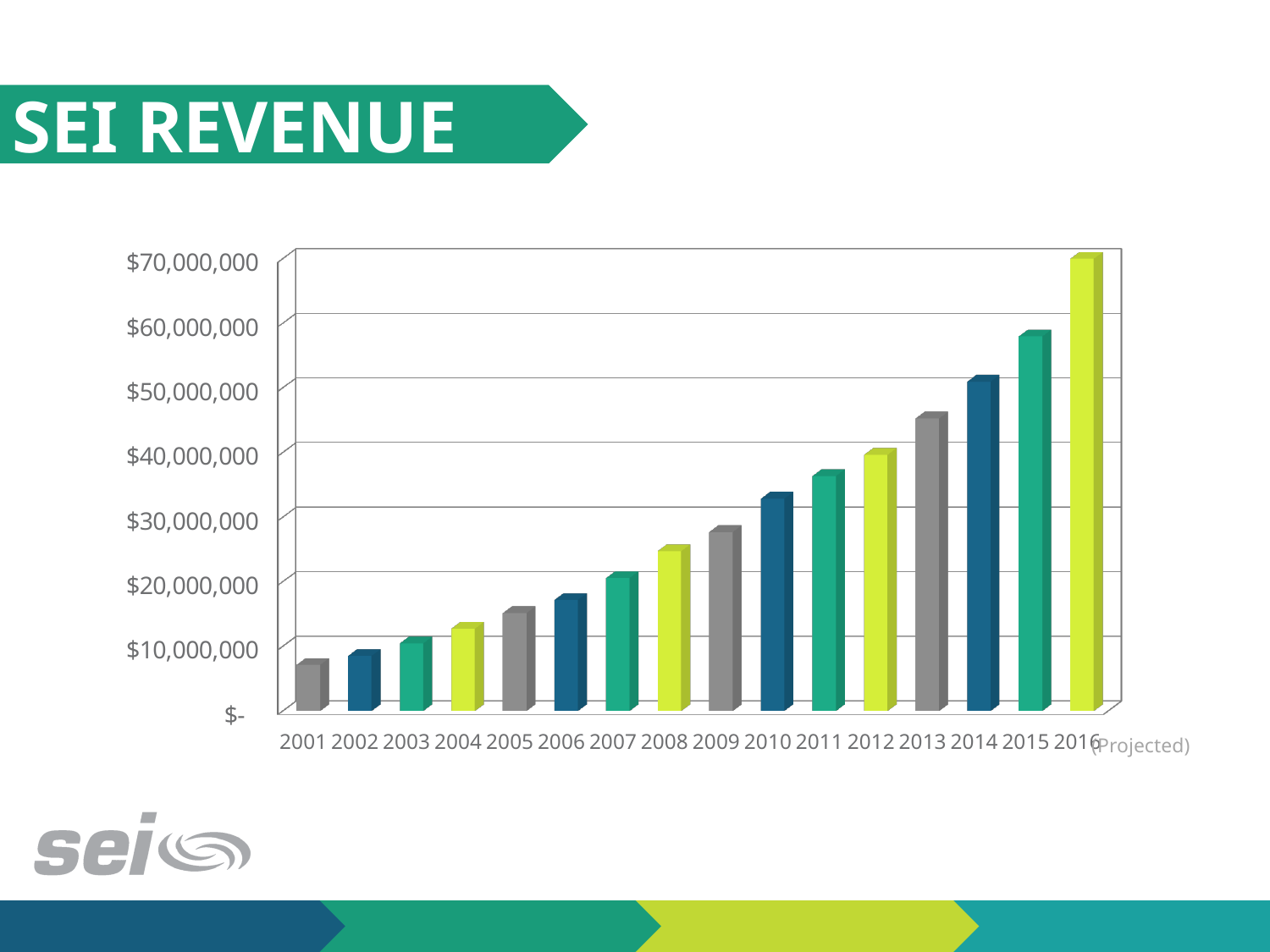
Which year has the highest revenue in the chart? 2016 What kind of chart is shown on the slide? bar chart Is the revenue for 2013 greater or less than $40,000,000? greater How many years are shown on the x axis of the chart? 16 Is the revenue for 2009 greater or less than $30,000,000? less Is the revenue for 2001 greater or less than $10,000,000? less Which year has the lowest revenue in the chart? 2001 Do the revenue values generally rise or fall from 2001 to 2016? rise What is the title of the chart? SEI REVENUE Which year has the larger revenue, 2010 or 2015? 2015